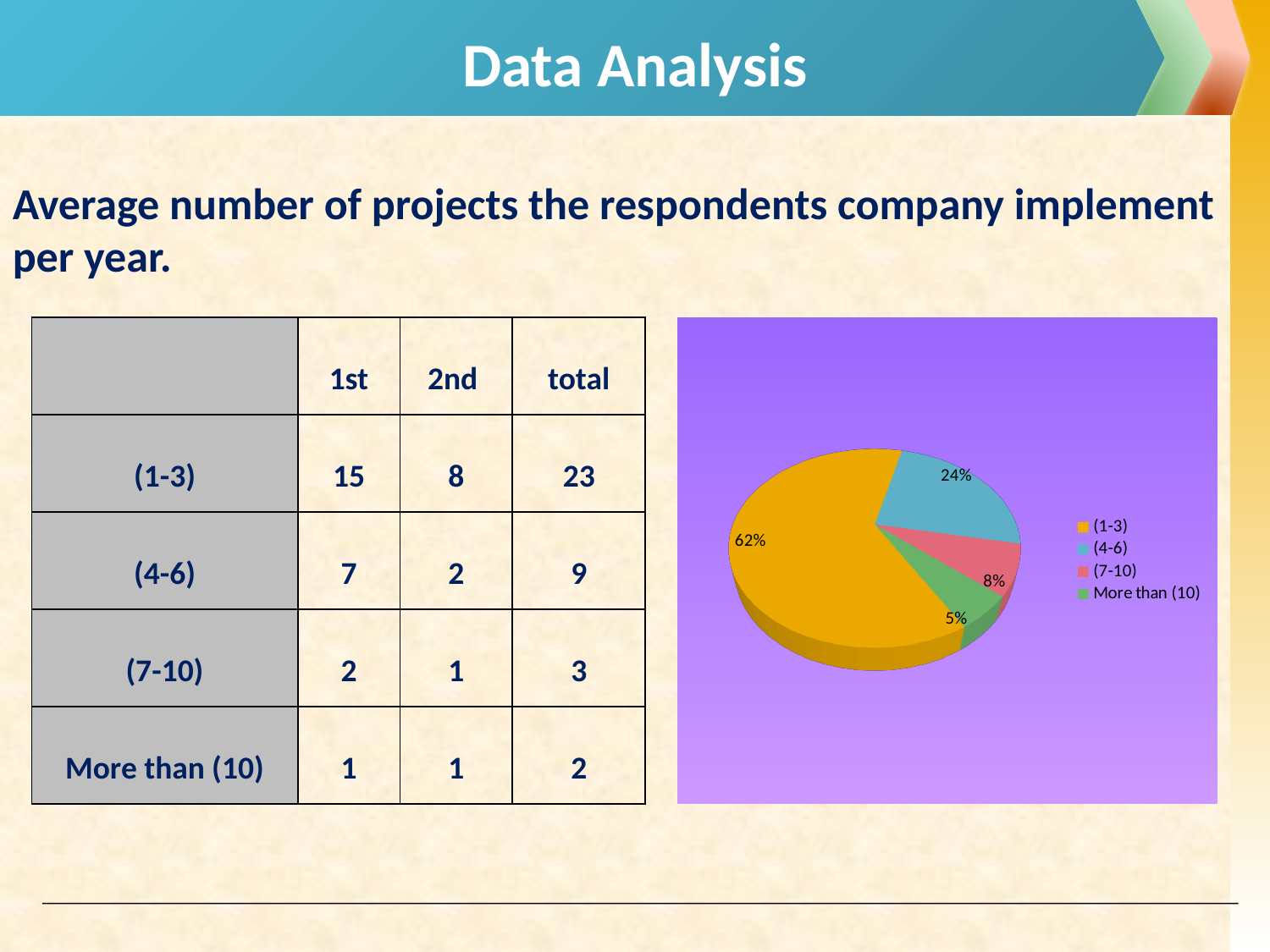
What is the difference between the (7-10) share and the More than (10) share? 3% What is the difference between the (1-3) share and the (4-6) share? 38% What kind of chart is shown on the slide? pie chart What share of the pie does the (1-3) slice represent? 62% How many slices does the pie chart have? 4 What colour is the (1-3) slice in the pie chart? yellow Which is larger, the (4-6) slice or the (7-10) slice? (4-6) Which category has the smallest slice of the pie? More than (10) What share of the pie does the (4-6) slice represent? 24% What is the value shown for the More than (10) slice? 5% Which category has the largest slice of the pie? (1-3) What is the value shown for the (7-10) slice? 8%